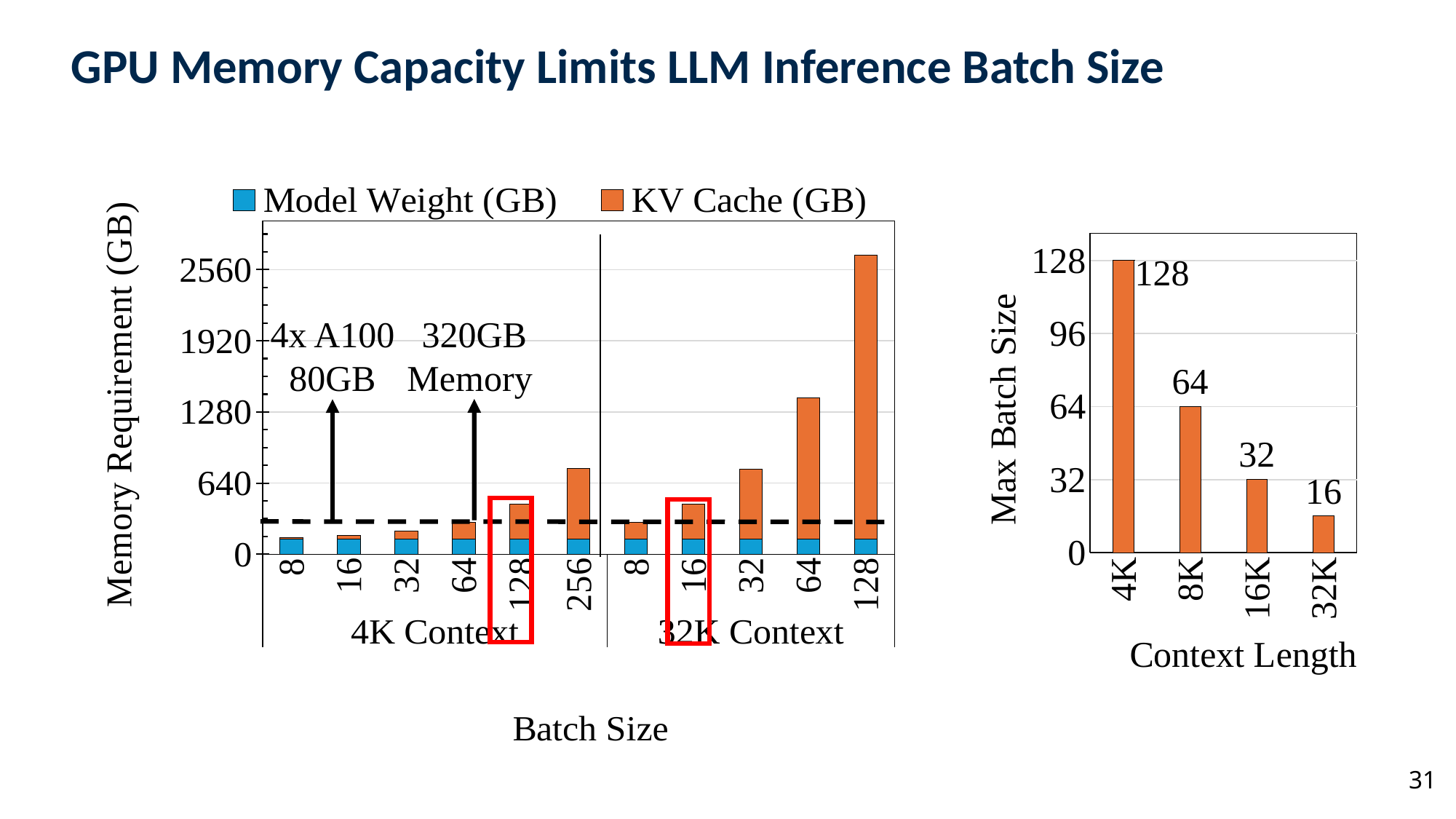
In the right chart (Max Batch Size vs Context Length), does the max batch size rise or fall as context length increases? fall In the left chart (Memory Requirement vs Batch Size), what kind of chart is it? stacked bar chart In the right chart (Max Batch Size vs Context Length), what is the max batch size for a 16K context length? 32 In the right chart (Max Batch Size vs Context Length), which context length has the lowest max batch size? 32K In the left chart (Memory Requirement vs Batch Size), is the total memory requirement for batch size 128 at 32K context greater or less than 2560? greater In the left chart (Memory Requirement vs Batch Size), is the total memory requirement for batch size 128 at 4K context greater or less than 640? less In the left chart (Memory Requirement vs Batch Size), which legend entry is shown in orange? KV Cache (GB) In the left chart (Memory Requirement vs Batch Size), how many series does the legend list? 2 In the right chart (Max Batch Size vs Context Length), how many context lengths are plotted? 4 In the right chart (Max Batch Size vs Context Length), what is the difference between the max batch size at 8K and at 32K context length? 48 In the right chart (Max Batch Size vs Context Length), what is the max batch size for a 4K context length? 128 In the left chart (Memory Requirement vs Batch Size), which batch size and context has the highest total memory requirement? 128 at 32K Context